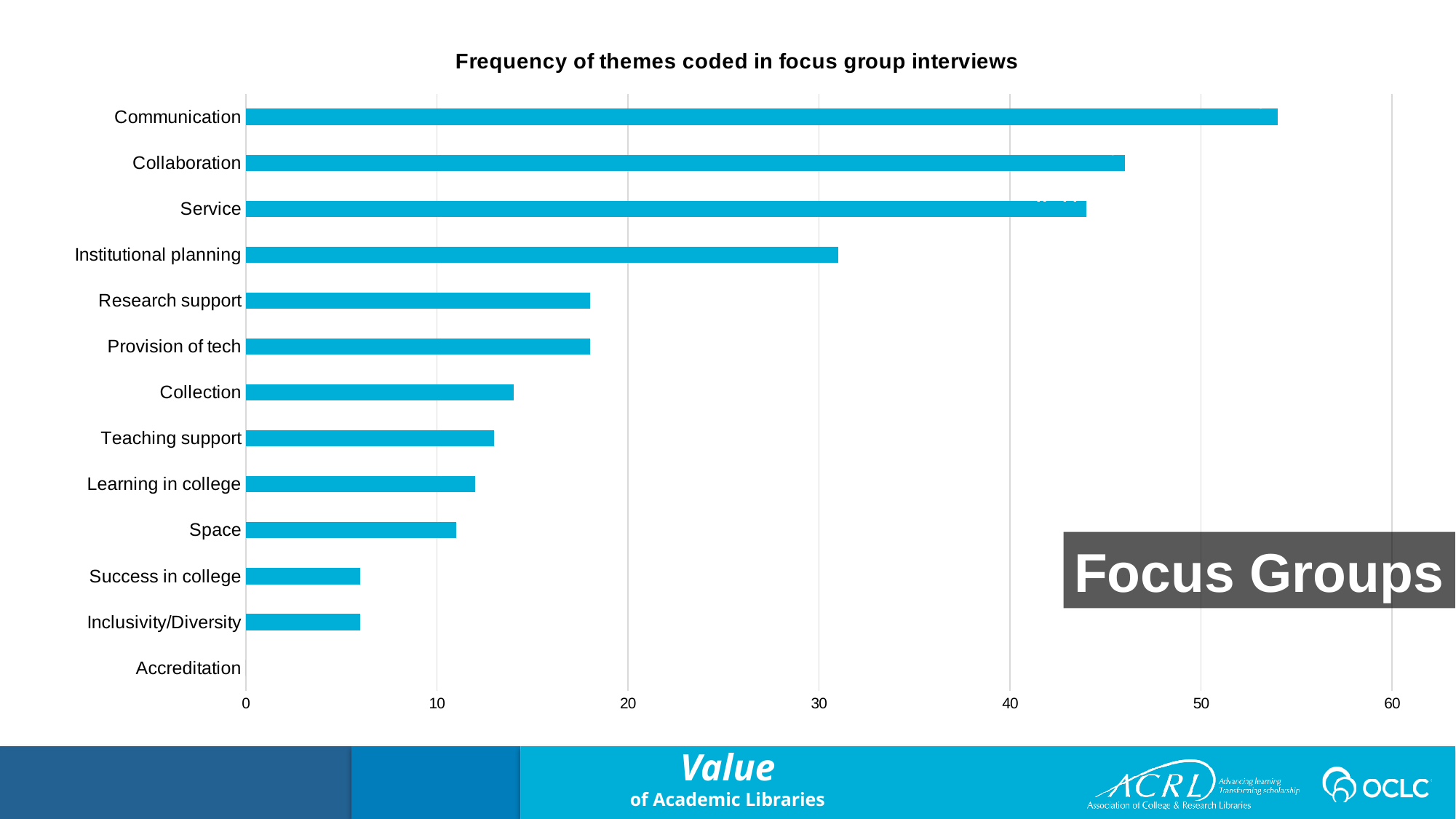
Which theme has the highest frequency? Communication Is the value for Research support greater or less than 20? less What is the value for Accreditation? 0 Is the value for Success in college greater or less than 10? less What kind of chart is shown on the slide? bar chart Is the value for Collaboration greater or less than 50? less Which has a higher frequency, Collection or Space? Collection Which theme has the lowest frequency? Accreditation What is the title of the chart? Frequency of themes coded in focus group interviews How many themes (categories) are listed on the chart? 13